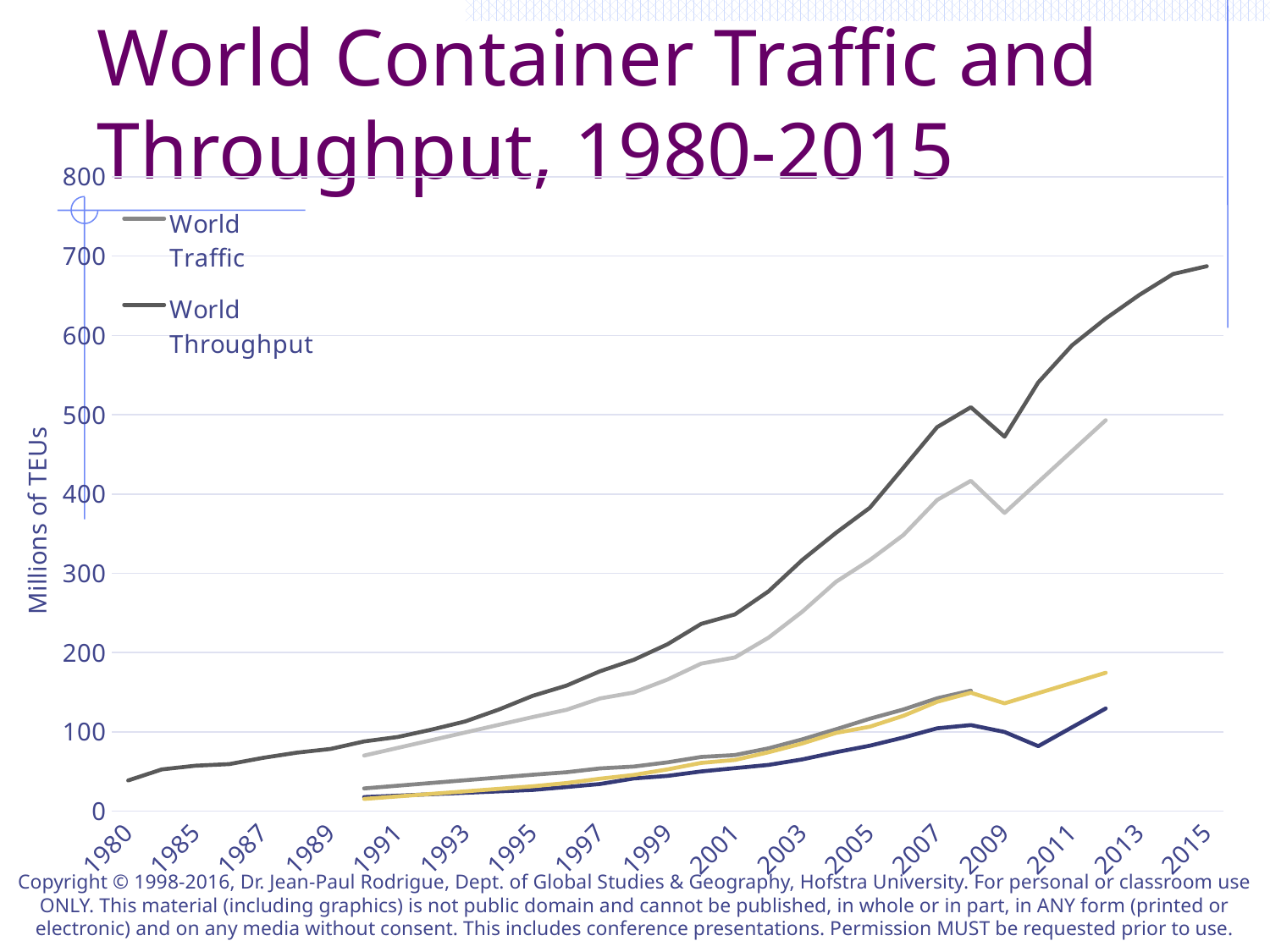
Is the value for World Throughput in 2005 greater or less than 300? greater What is the label on the vertical axis? Millions of TEUs In 2007, which is larger, World Throughput or World Traffic? World Throughput Is the value for World Throughput in 2009 greater or less than 400? greater How many series does the legend list? 2 Is the value for World Traffic in 2001 greater or less than 300? less Overall, does World Throughput rise or fall from 1980 to 2015? rise What kind of chart is shown on the slide? line chart What is the title of the chart? World Container Traffic and Throughput, 1980-2015 In which year does World Throughput reach its highest value? 2015